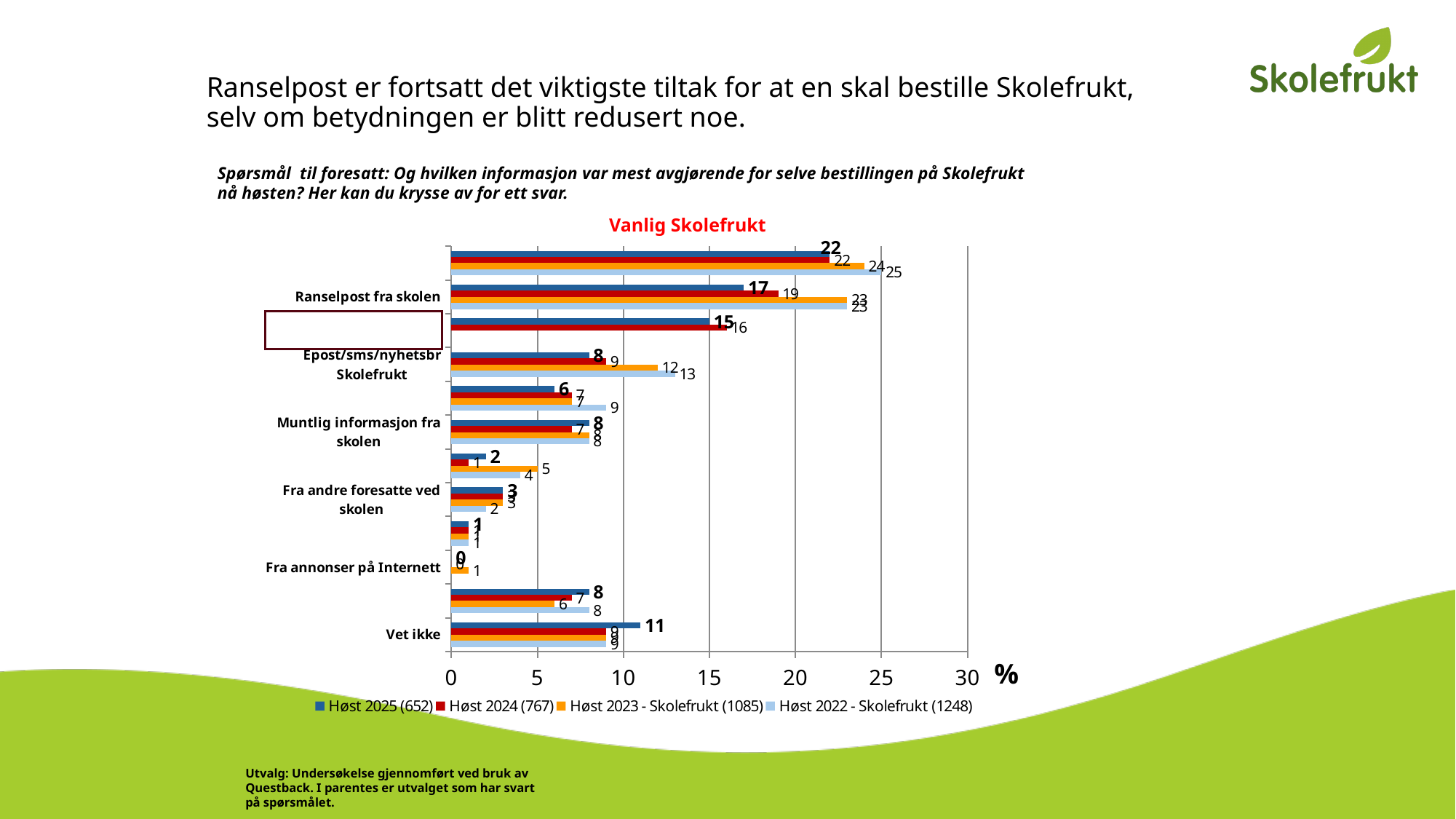
What is the value for "Vet ikke" in the Høst 2024 (767) series? 9 What is the title printed in red above the chart? Vanlig Skolefrukt What is the value for "Fra annonser på Internett" in the Høst 2023 - Skolefrukt (1085) series? 1 What is the value for "Vet ikke" in the Høst 2025 (652) series? 11 For "Vet ikke", which series has the larger value: Høst 2025 (652) or Høst 2022 - Skolefrukt (1248)? Høst 2025 (652) Is the value for "Vet ikke" in the Høst 2025 (652) series greater or less than 10? greater What is the difference between the Høst 2025 (652) and Høst 2024 (767) values for "Vet ikke"? 2 What is the highest value shown on the horizontal axis of the chart? 30 How many series does the legend of the chart list? 4 What kind of chart is shown under the title "Vanlig Skolefrukt"? bar chart What is the value for "Fra andre foresatte ved skolen" in the Høst 2025 (652) series? 3 What is the value for "Fra annonser på Internett" in the Høst 2025 (652) series? 0